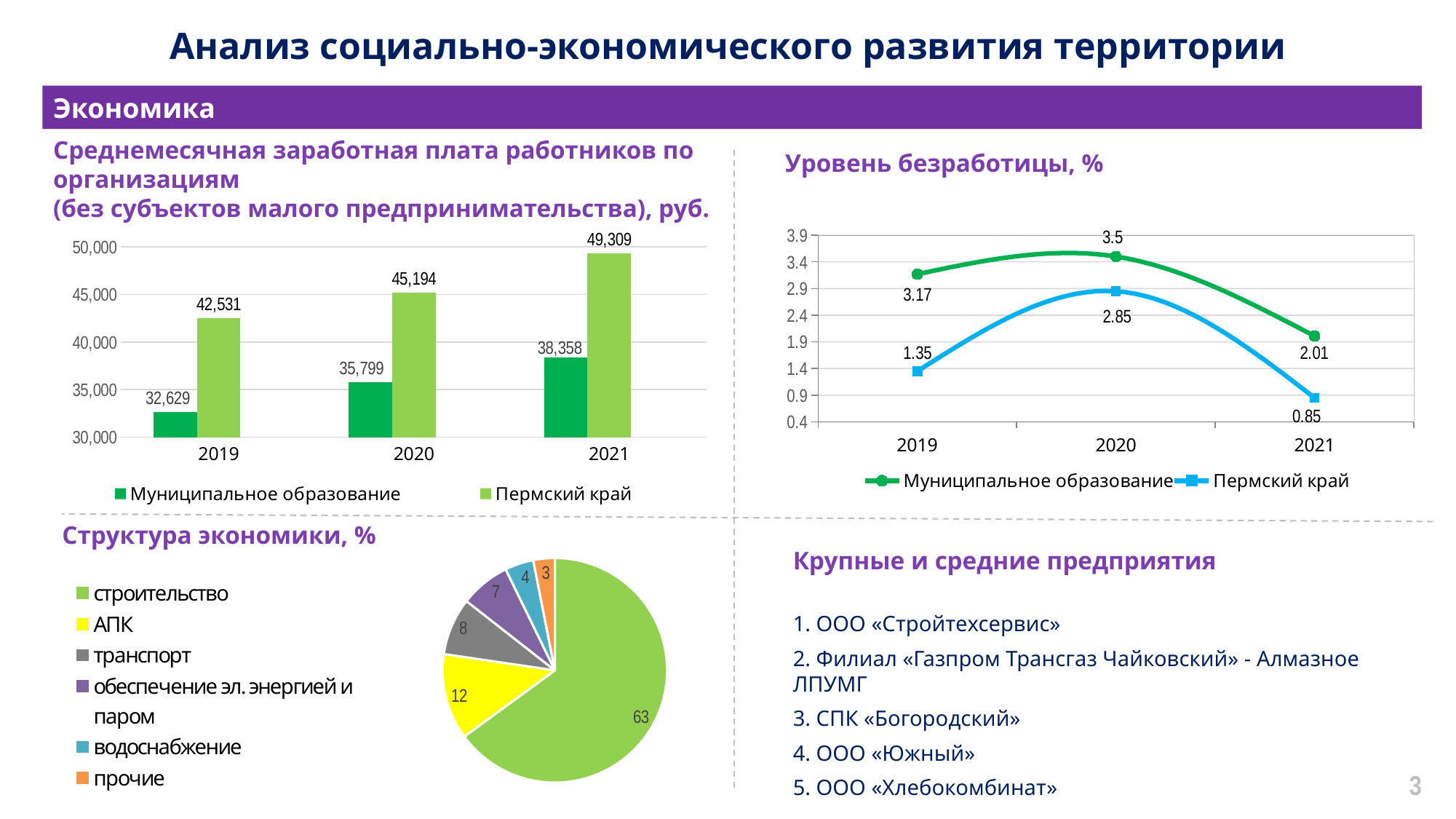
In the chart 'Среднемесячная заработная плата работников по организациям', what is the value for Пермский край in 2021? 49,309 How many series does the legend of the chart 'Уровень безработицы, %' list? 2 In the pie chart 'Структура экономики, %', what is the value for АПК? 12 In the chart 'Уровень безработицы, %', which series has the larger value in 2021, Муниципальное образование or Пермский край? Муниципальное образование What kind of chart is 'Среднемесячная заработная плата работников по организациям'? bar chart In the chart 'Уровень безработицы, %', what is the value for Пермский край in 2020? 2.85 How many categories does the pie chart 'Структура экономики, %' show? 6 In the chart 'Среднемесячная заработная плата работников по организациям', does the value for Муниципальное образование rise or fall from 2019 to 2021? rise In the chart 'Уровень безработицы, %', in which year is the value for Муниципальное образование highest? 2020 In the chart 'Среднемесячная заработная плата работников по организациям', what is the difference between Пермский край and Муниципальное образование in 2020? 9,395 In the chart 'Среднемесячная заработная плата работников по организациям', what is the value for Муниципальное образование in 2019? 32,629 In the pie chart 'Структура экономики, %', which category has the smallest share? прочие